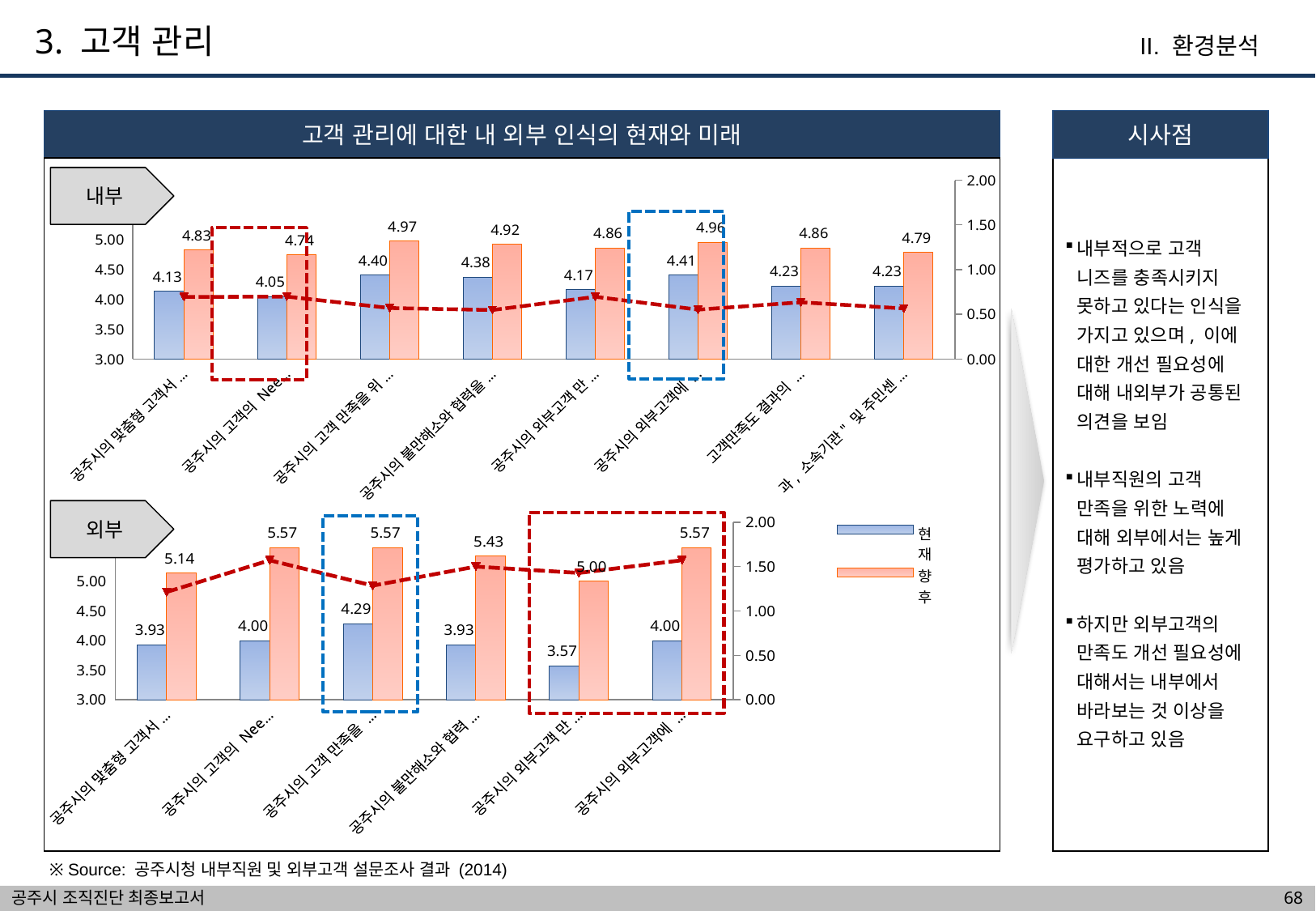
In the top (내부) chart, what is the 향후 value for the last (eighth) category? 4.79 In the bottom (외부) chart, which category has the lowest 현재 value? The fifth category (3.57) In the bottom (외부) chart, how many categories are plotted along the x axis? 6 In the top (내부) chart, what is the 현재 value for the first category? 4.13 In the top (내부) chart, which is larger: the 현재 value for the second category or the 현재 value for the third category? The third category (4.40) In the bottom (외부) chart, what is the 향후 value for the first category? 5.14 In the top (내부) chart, how many categories are plotted along the x axis? 8 How many series does the legend list? 2 In the top (내부) chart, what is the difference between the 향후 and 현재 values for the first category? 0.70 In the bottom (외부) chart, what is the highest 현재 value? 4.29 In the bottom (외부) chart, what is the difference between the 향후 and 현재 values for the fifth category? 1.43 What is the title of the chart panel on the slide? 고객 관리에 대한 내 외부 인식의 현재와 미래